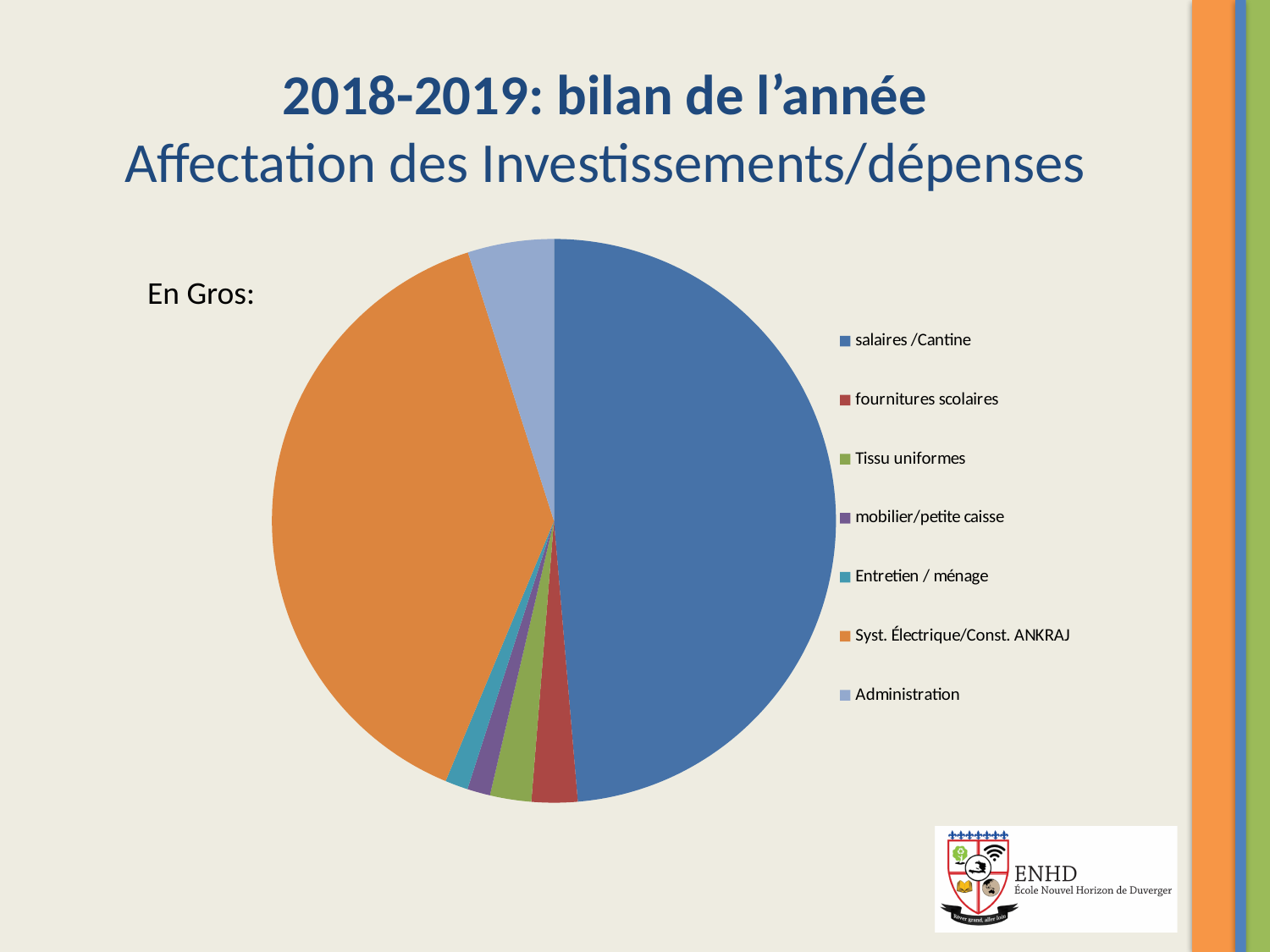
What is the subtitle of the slide above the pie chart? Affectation des Investissements/dépenses Which category has the largest slice of the pie chart? salaires /Cantine Which is larger, the slice for Syst. Électrique/Const. ANKRAJ or the slice for Tissu uniformes? Syst. Électrique/Const. ANKRAJ Which is larger, the slice for salaires /Cantine or the slice for Syst. Électrique/Const. ANKRAJ? salaires /Cantine How many categories does the pie chart show? 7 What colour is the slice for salaires /Cantine? blue Which is larger, the slice for Administration or the slice for fournitures scolaires? Administration Which category is the second-largest slice of the pie chart? Syst. Électrique/Const. ANKRAJ What kind of chart is shown on the slide? pie chart